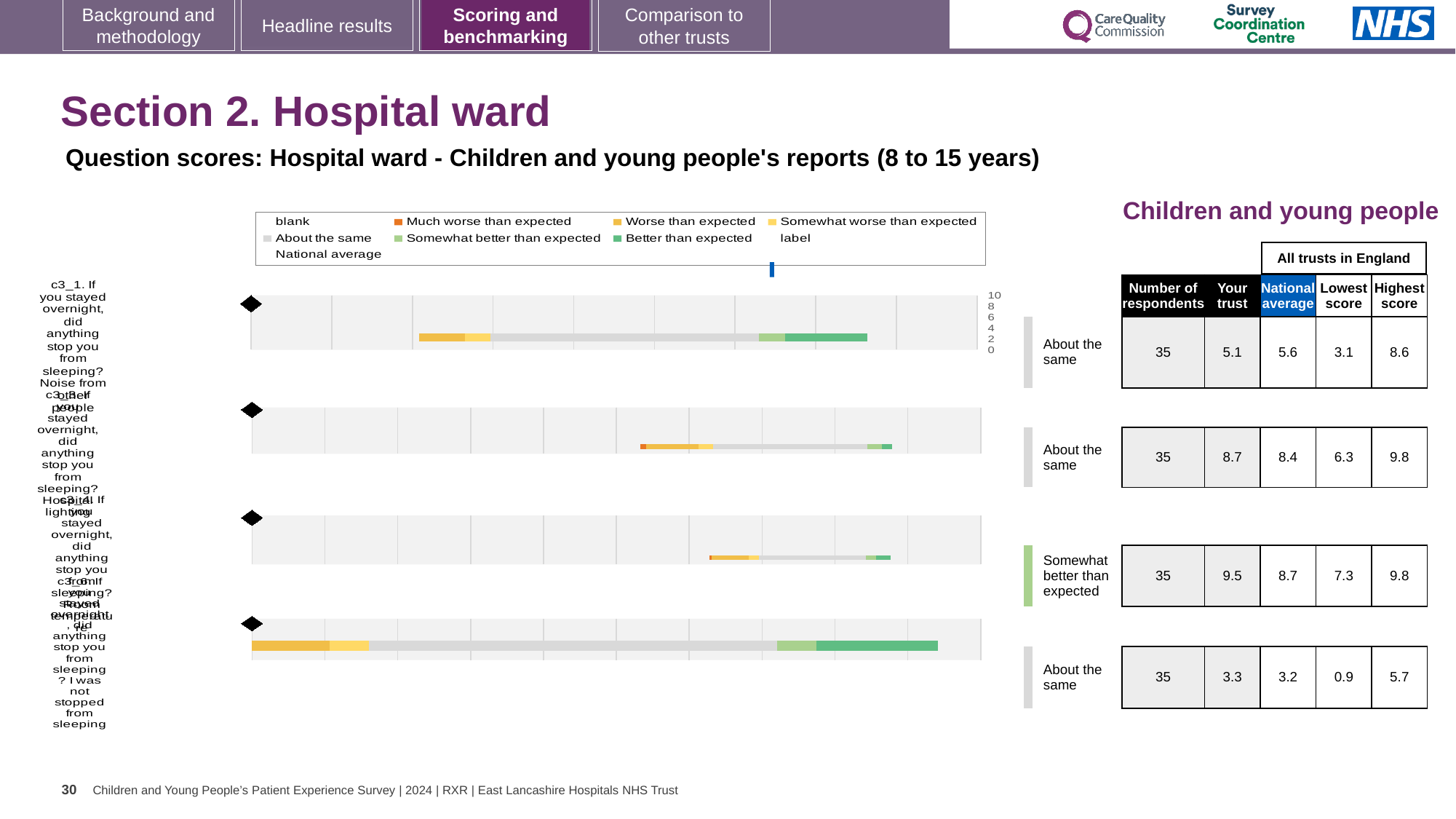
Which chart row has the highest 'Your trust' score? the third chart from the top (9.5) How many respondents are shown for the top chart? 35 What kind of chart is used to show the question scores on this slide? bar chart What colour does the legend use for 'Much worse than expected'? orange How many entries does the chart legend list? 9 For the third chart from the top, what is the national average score shown in the table? 8.7 For the bottom chart, which is higher: the 'Your trust' score or the national average? Your trust For the second chart from the top, what is the difference between the highest score (9.8) and the lowest score (6.3) across all trusts in England? 3.5 For the top chart (noise from other people), what is the 'Your trust' score shown in the table? 5.1 How many separate bar charts (question rows) are shown on the slide? 4 What colour does the legend use for 'Better than expected'? green Which chart row has the lowest 'Your trust' score? the bottom chart (3.3)